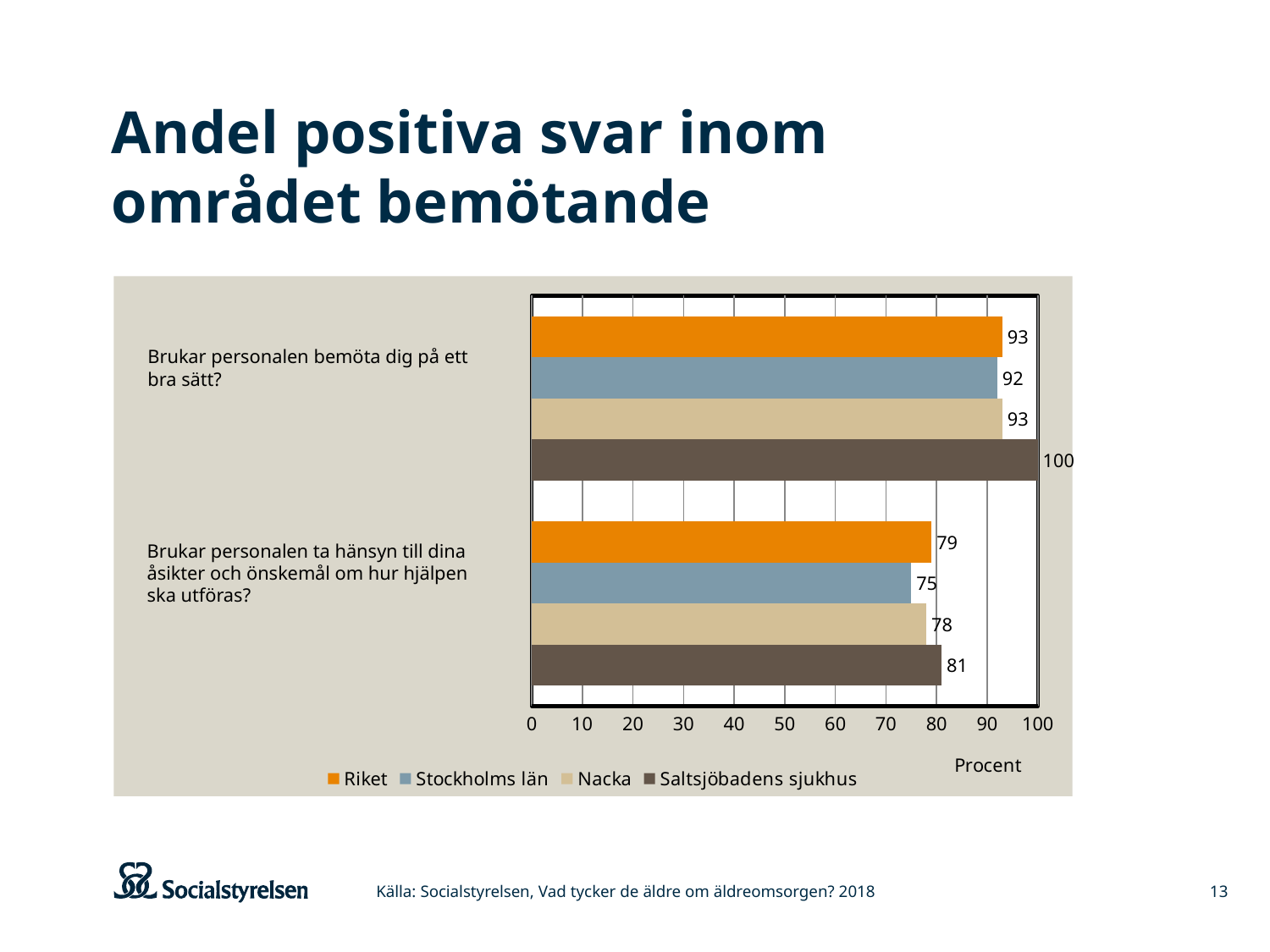
How many series does the legend list? 4 What is the value for Riket for the question "Brukar personalen ta hänsyn till dina åsikter och önskemål om hur hjälpen ska utföras?"? 79 Which series has the lowest value for the question "Brukar personalen ta hänsyn till dina åsikter och önskemål om hur hjälpen ska utföras?"? Stockholms län How many questions (categories) are shown on the chart? 2 What is the value for Saltsjöbadens sjukhus for the question "Brukar personalen bemöta dig på ett bra sätt?"? 100 What is the label of the x axis? Procent Which series has the highest value for the question "Brukar personalen bemöta dig på ett bra sätt?"? Saltsjöbadens sjukhus Which is larger for the question "Brukar personalen ta hänsyn till dina åsikter och önskemål om hur hjälpen ska utföras?": the Saltsjöbadens sjukhus value or the Stockholms län value? Saltsjöbadens sjukhus What is the difference between the Riket value and the Nacka value for the question "Brukar personalen ta hänsyn till dina åsikter och önskemål om hur hjälpen ska utföras?"? 1 What kind of chart is shown on the slide? Bar chart What is the value for Stockholms län for the question "Brukar personalen ta hänsyn till dina åsikter och önskemål om hur hjälpen ska utföras?"? 75 What is the difference between the Saltsjöbadens sjukhus value and the Stockholms län value for the question "Brukar personalen bemöta dig på ett bra sätt?"? 8